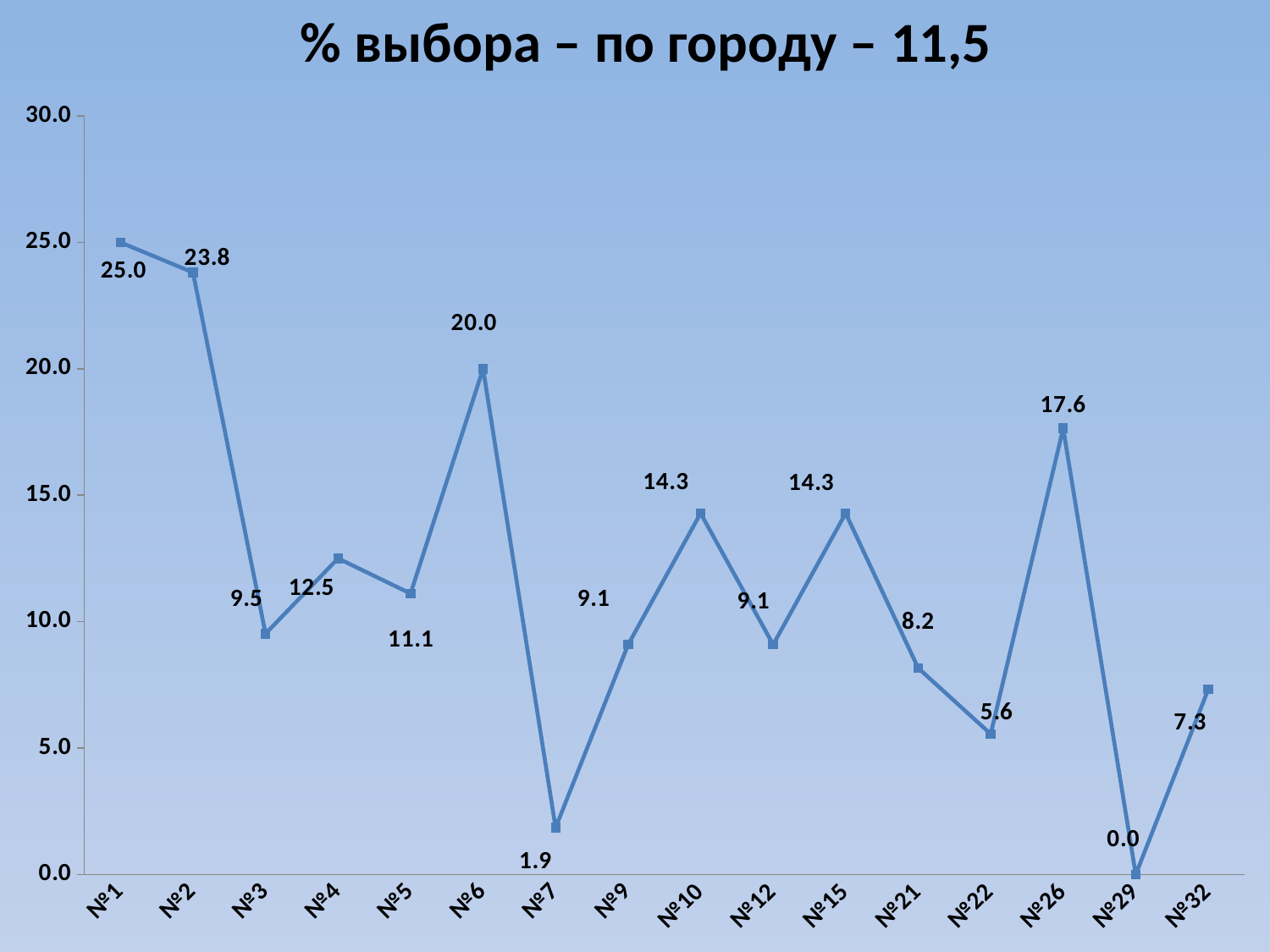
How many categories are plotted on the x axis? 16 Which category has the highest value? №1 What is the difference between the values for №1 and №2? 1.2 Do the values rise or fall from №1 to №3? fall What is the value for №6? 20.0 What is the value for №1? 25.0 Which is larger, the value for №4 or the value for №5? №4 What type of chart is shown on the slide? line chart What is the title of the chart? % выбора – по городу – 11,5 Which category has the lowest value? №29 What is the value for №26? 17.6 What is the value for №7? 1.9